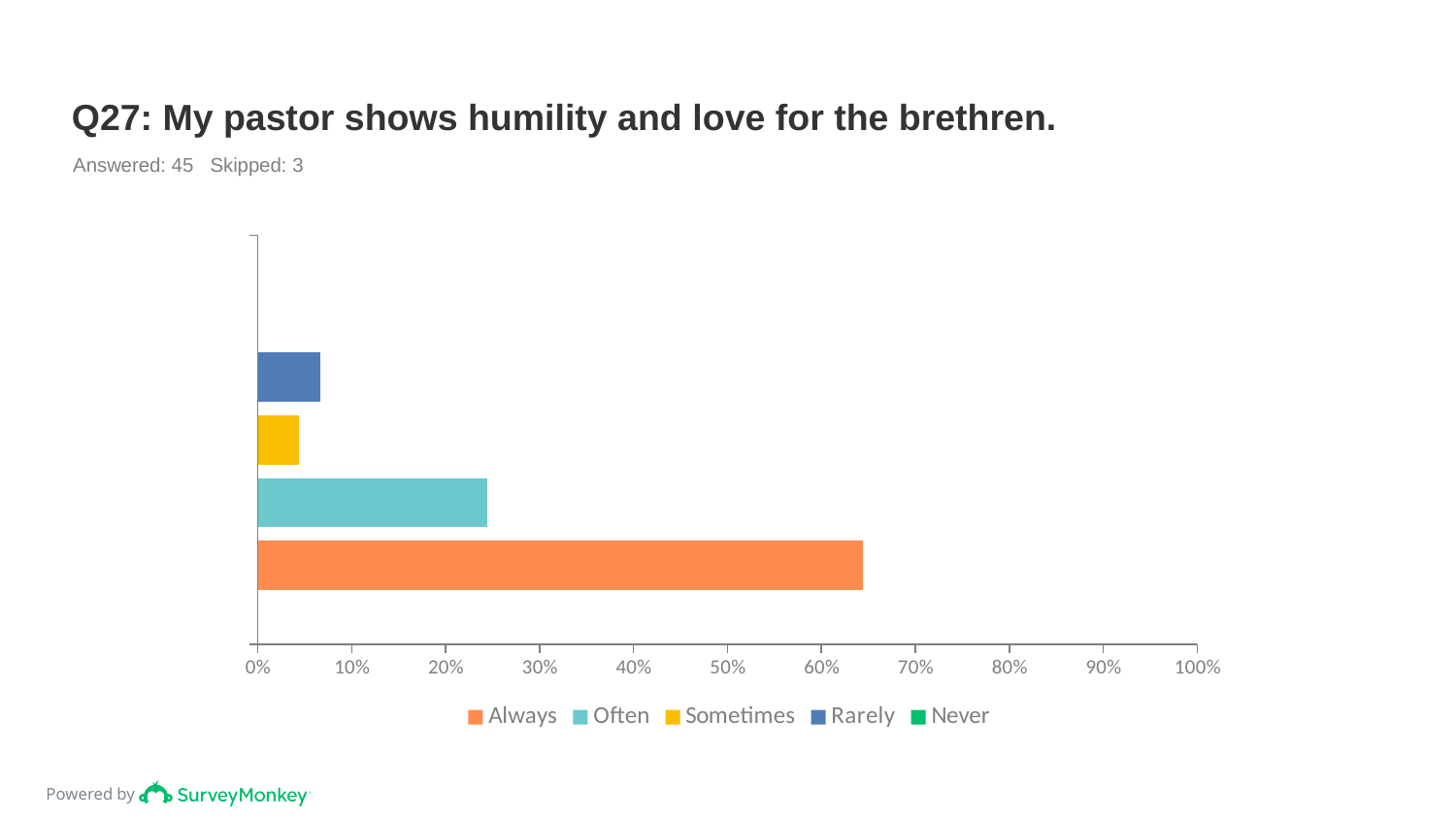
Is the value for Often greater or less than 20%? greater Which is larger, the value for Always or the value for Often? Always Is the value for Sometimes greater or less than 10%? less Is the value for Rarely greater or less than 10%? less Which is larger, the value for Rarely or the value for Sometimes? Rarely What is the title of the chart? Q27: My pastor shows humility and love for the brethren. What kind of chart is shown on the slide? Bar chart Which response category has the highest value? Always Which response category has the lowest value? Never How many series does the legend list? 5